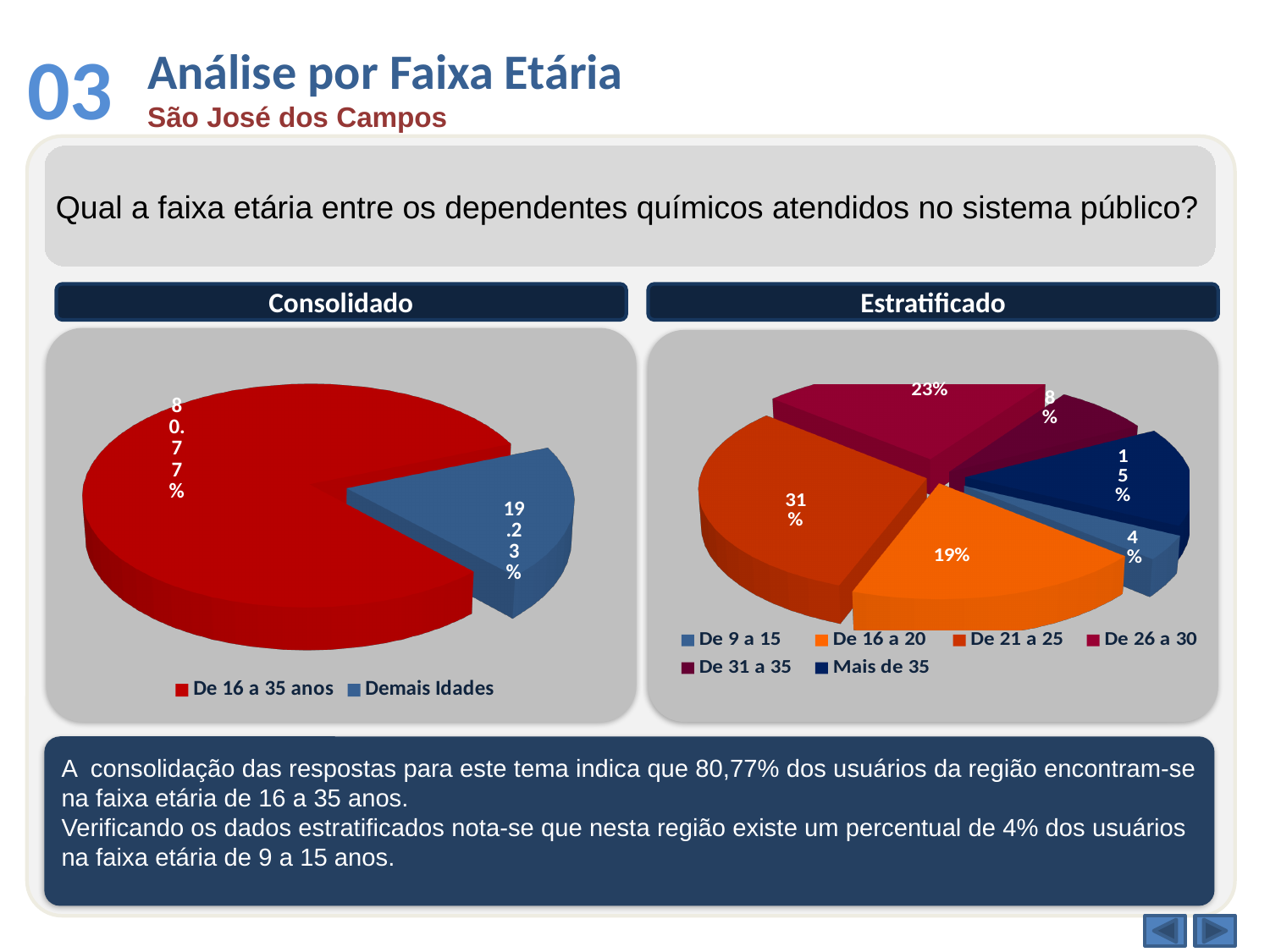
What kind of chart is the Consolidado chart? Pie chart In the Estratificado chart, which category has the largest share? De 21 a 25 In the Consolidado chart, what is the value for De 16 a 35 anos? 80.77% In the Estratificado chart, what is the value for De 21 a 25? 31% In the Estratificado chart, which is larger: De 31 a 35 or Mais de 35? Mais de 35 In the Consolidado chart, what is the value for Demais Idades? 19.23% How many categories does the legend of the Estratificado chart list? 6 In the Estratificado chart, what is the value for De 9 a 15? 4% In the Consolidado chart, which category has the largest share? De 16 a 35 anos In the Estratificado chart, what is the difference between De 26 a 30 and De 16 a 20? 4% In the Estratificado chart, which category has the smallest share? De 9 a 15 In the Estratificado chart, what is the value for Mais de 35? 15%